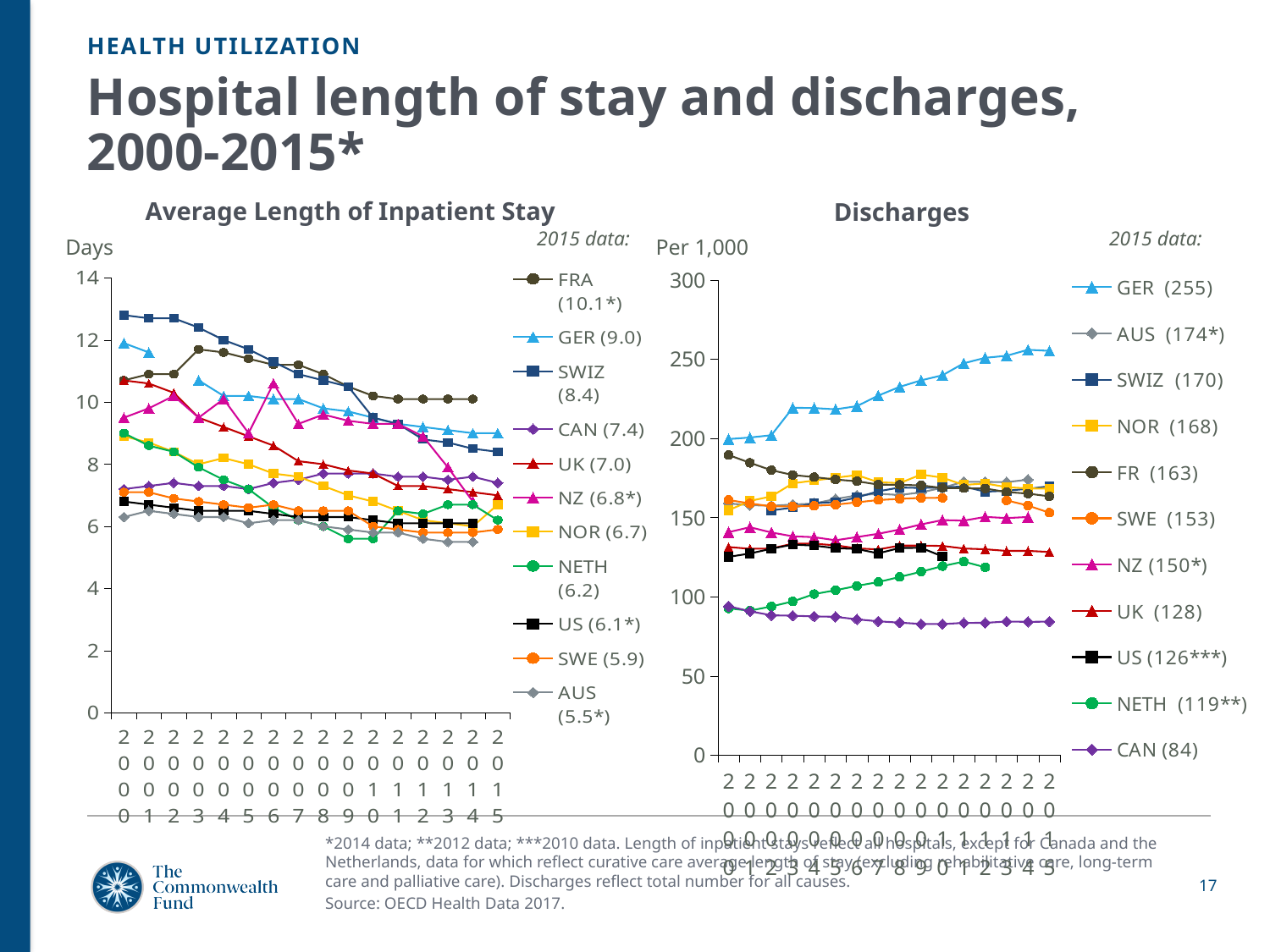
In the Discharges chart, is the CAN value in 2015 greater or less than 100 per 1,000? less What type of chart is the Average Length of Inpatient Stay chart? line chart In the Average Length of Inpatient Stay chart, what is the 2015 value for FRA shown in the legend? 10.1* In the Discharges chart, which country has the highest 2015 value in the legend? GER (255) In the Average Length of Inpatient Stay chart, what is the 2015 value for NETH shown in the legend? 6.2 In the Discharges chart, what is the 2015 value for SWE shown in the legend? 153 In the Discharges chart, does the GER line rise or fall from 2000 to 2015? rise How many series does the legend of the Average Length of Inpatient Stay chart list? 11 In the Average Length of Inpatient Stay chart, is the SWIZ value in 2000 greater or less than 12 days? greater In the Discharges chart, what is the difference between the 2015 legend values for GER and CAN? 171 In the Average Length of Inpatient Stay chart, does the SWIZ line rise or fall from 2000 to 2015? fall In the Average Length of Inpatient Stay chart, which country has the lowest 2015 value in the legend? AUS (5.5*)